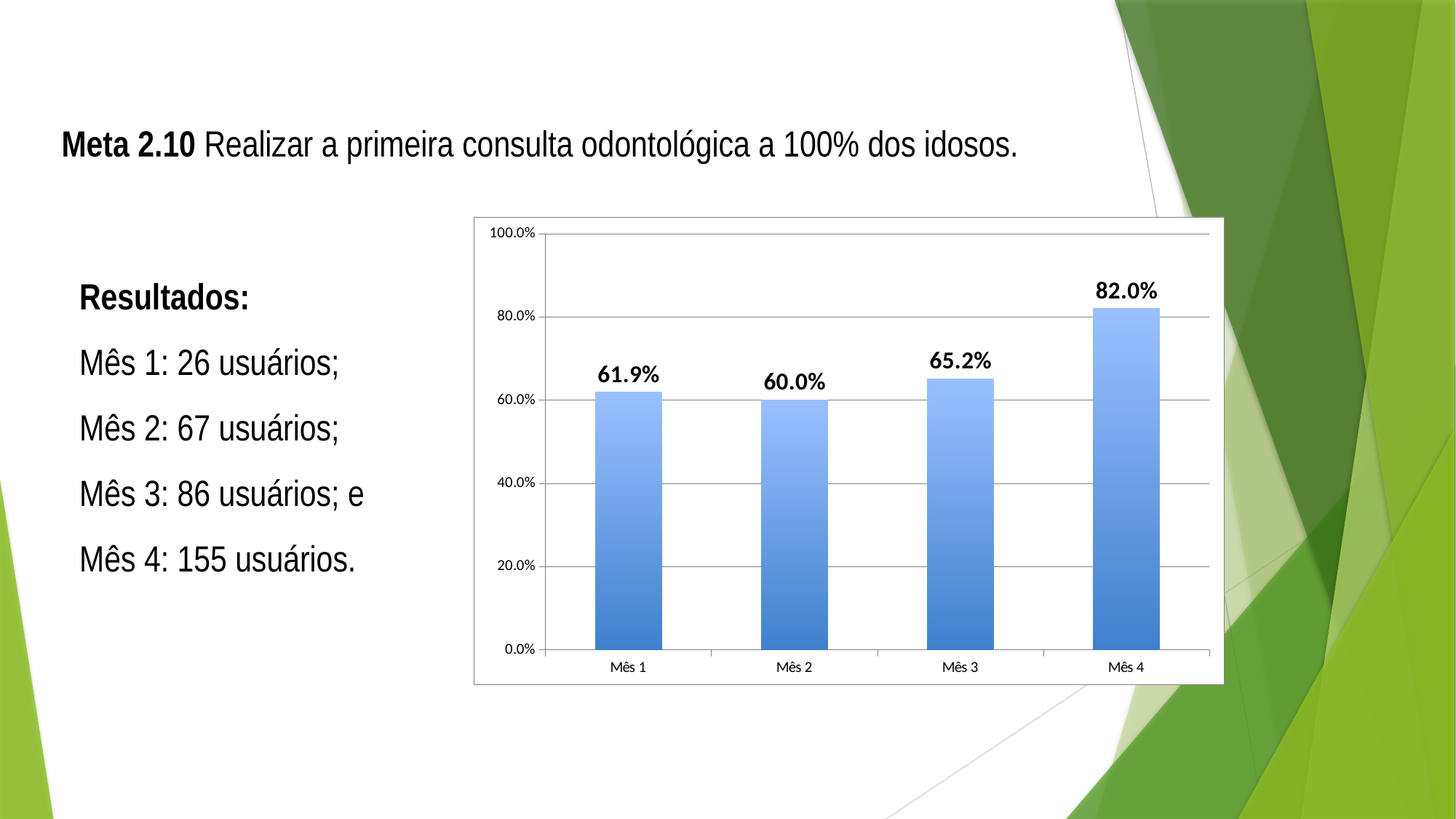
What is the value for Mês 3? 65.2% Is the value for Mês 4 greater or less than 80.0%? greater Which month has the highest value? Mês 4 What is the value for Mês 4? 82.0% Which month has the lowest value? Mês 2 How many months are shown on the x axis? 4 What is the difference between the values for Mês 3 and Mês 2? 5.2% What is the value for Mês 1? 61.9% What kind of chart is shown on the slide? Bar chart What is the difference between the values for Mês 4 and Mês 1? 20.1% Which is larger, the value for Mês 1 or the value for Mês 3? Mês 3 What is the value for Mês 2? 60.0%